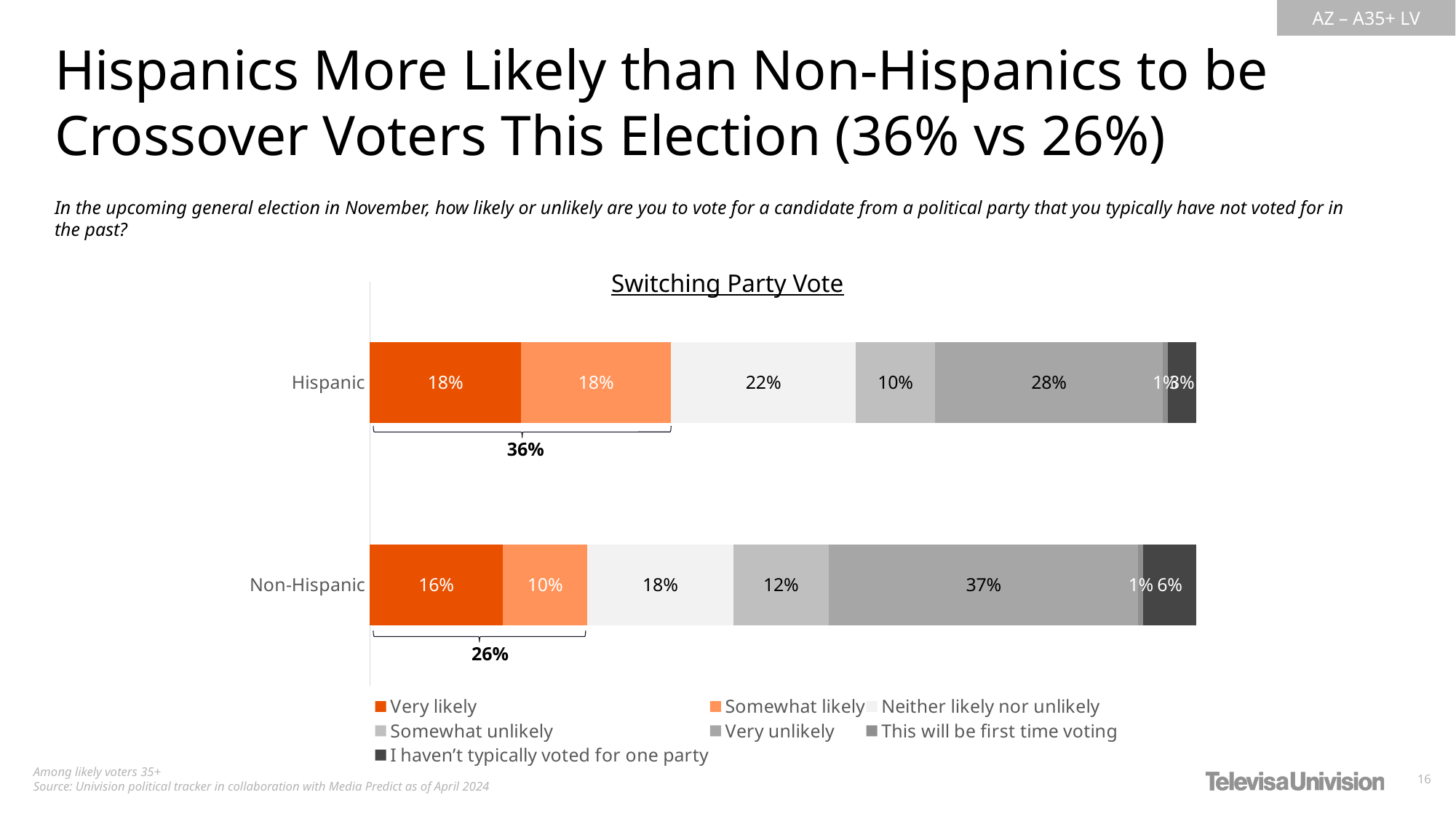
What percentage of Non-Hispanic respondents said Somewhat likely? 10% What type of chart is shown on the slide? Stacked bar chart How many groups (bars) are shown in the chart? 2 How many percentage points higher is Very unlikely for Non-Hispanic respondents than for Hispanic respondents? 9 percentage points How many response categories does the legend list? 7 What is the value for Neither likely nor unlikely in the Hispanic bar? 22% What percentage of Non-Hispanic respondents said they haven't typically voted for one party? 6% What percentage of Hispanic respondents said they are very likely to vote for a candidate from a party they typically have not voted for? 18% Which group has the larger Somewhat unlikely share, Hispanic or Non-Hispanic? Non-Hispanic Which response category is the largest segment in the Non-Hispanic bar? Very unlikely What is the combined share of Very likely and Somewhat likely for Hispanic respondents? 36% What is the value for Very unlikely among Non-Hispanic respondents? 37%